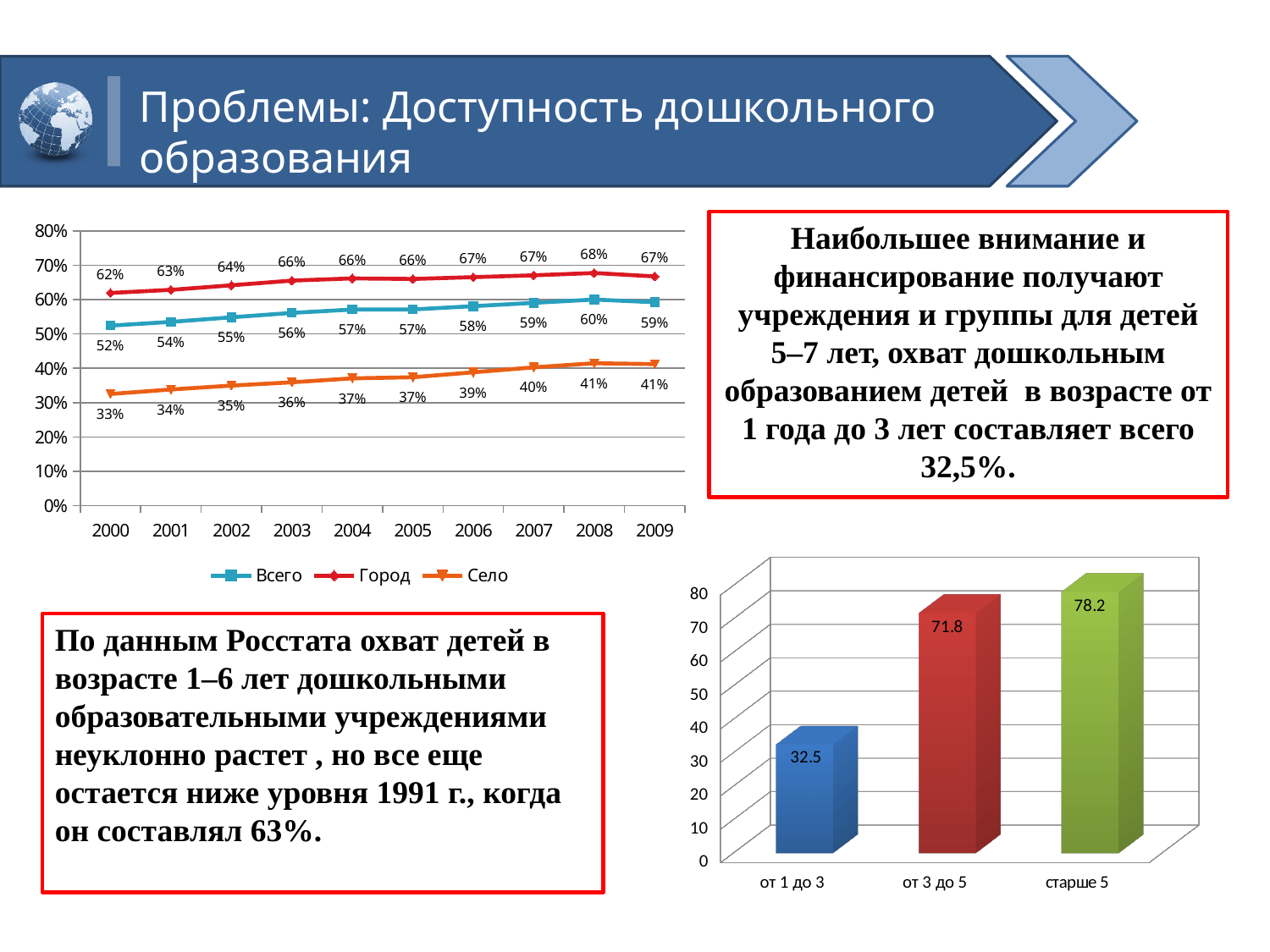
What kind of chart is shown on the bottom right of the slide? bar chart In the line chart on the left, how many years are shown on the x axis? 10 In the line chart on the left, what is the difference between Город and Село in 2009? 26% In the bar chart on the bottom right, what is the value for от 3 до 5? 71.8 In the line chart on the left, what is the value for Город in 2008? 68% In the line chart on the left, what is the value for Всего in 2009? 59% In the line chart on the left, how many series does the legend list? 3 In the line chart on the left, does the Село series generally rise or fall from 2000 to 2009? rise In the bar chart on the bottom right, which category has the lowest value? от 1 до 3 In the line chart on the left, which series has the highest values across all years? Город In the line chart on the left, what is the value for Село in 2000? 33% In the bar chart on the bottom right, what is the difference between старше 5 and от 1 до 3? 45.7